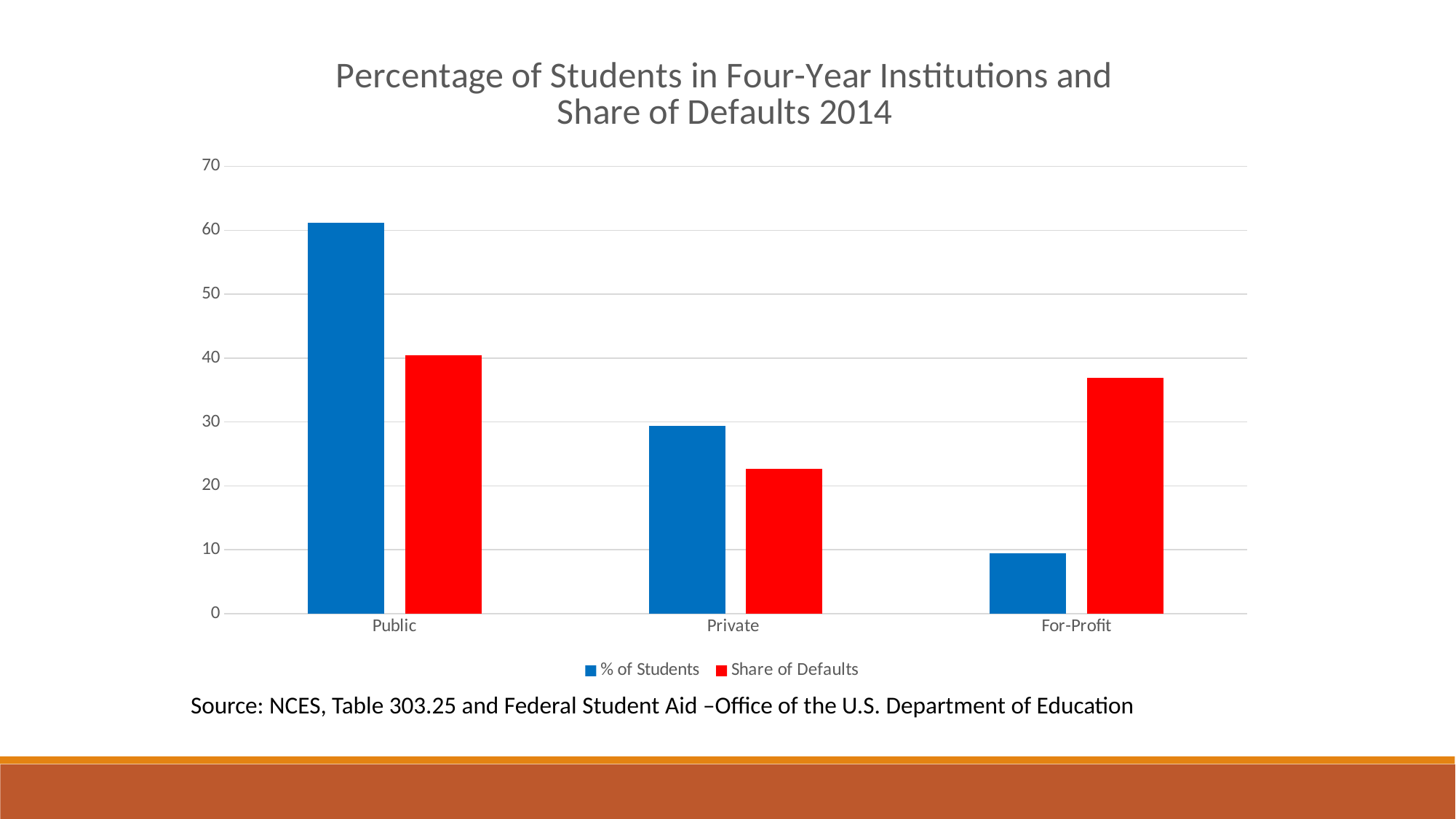
Is the Share of Defaults value for For-Profit greater or less than 30? greater How many categories are shown on the x axis? 3 Is the % of Students value for For-Profit greater or less than 20? less How many series does the legend list? 2 For the For-Profit category, which is larger: % of Students or Share of Defaults? Share of Defaults For the Public category, which is larger: % of Students or Share of Defaults? % of Students What type of chart is shown on the slide? bar chart What colour are the bars for the Share of Defaults series? red Is the % of Students value for Public greater or less than 50? greater Which category has the lowest value for Share of Defaults? Private Which category has the highest value for % of Students? Public Which category has the lowest value for % of Students? For-Profit